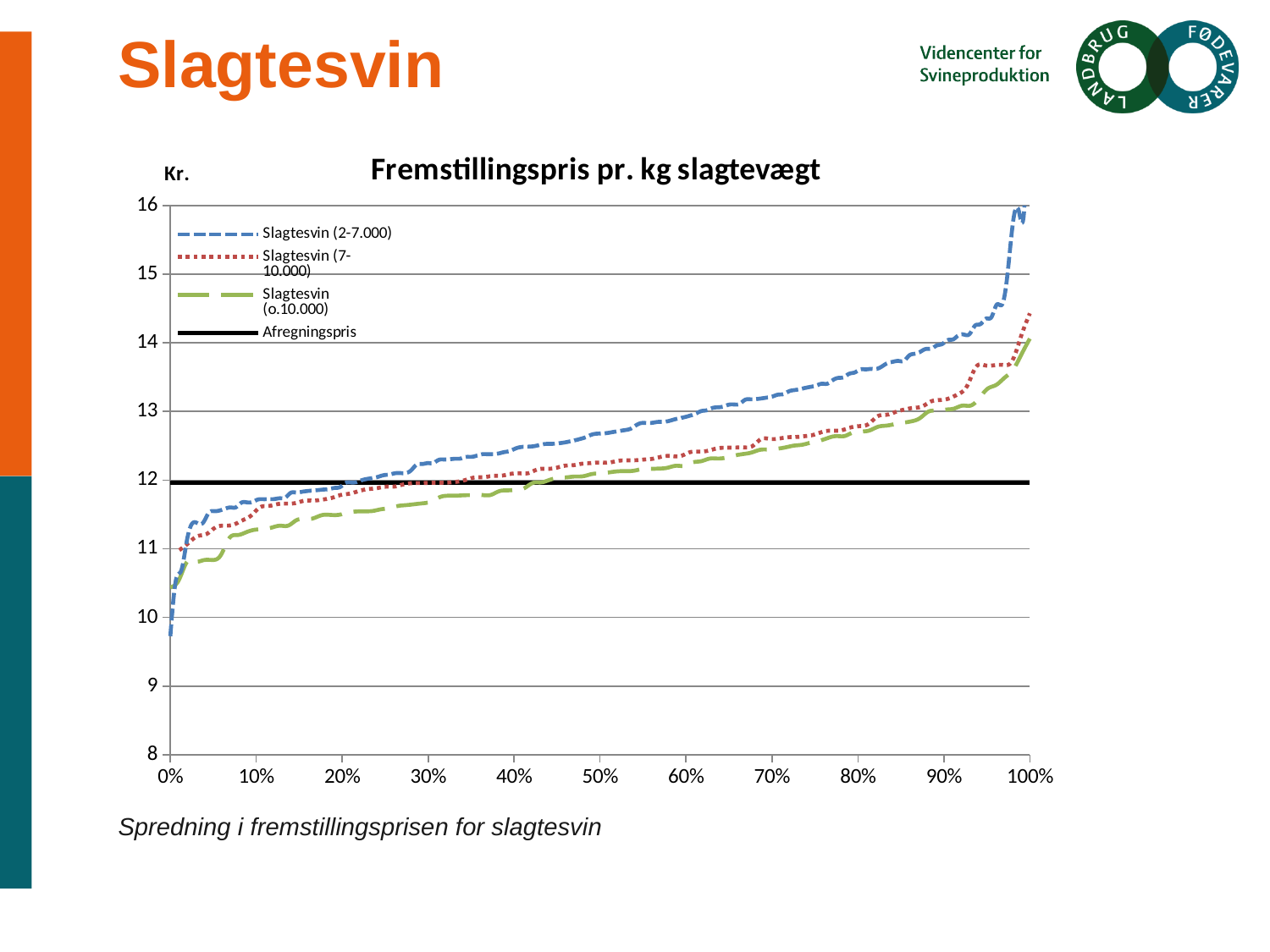
Is the value for Slagtesvin (o.10.000) at 20% greater or less than 12? less What kind of chart is shown on the slide? Line chart What unit label is shown at the top of the vertical axis? Kr. At 50%, which is higher: Slagtesvin (2-7.000) or Slagtesvin (o.10.000)? Slagtesvin (2-7.000) Is the value for Slagtesvin (2-7.000) at 50% greater or less than 13? less Do the values of the Slagtesvin (2-7.000) series rise or fall from 0% to 100% along the x axis? Rise Is the Afregningspris line greater or less than 13? less How many series does the legend of the chart list? 4 What is the title of the chart? Fremstillingspris pr. kg slagtevægt Which of the three Slagtesvin series has the highest value at 90%? Slagtesvin (2-7.000)